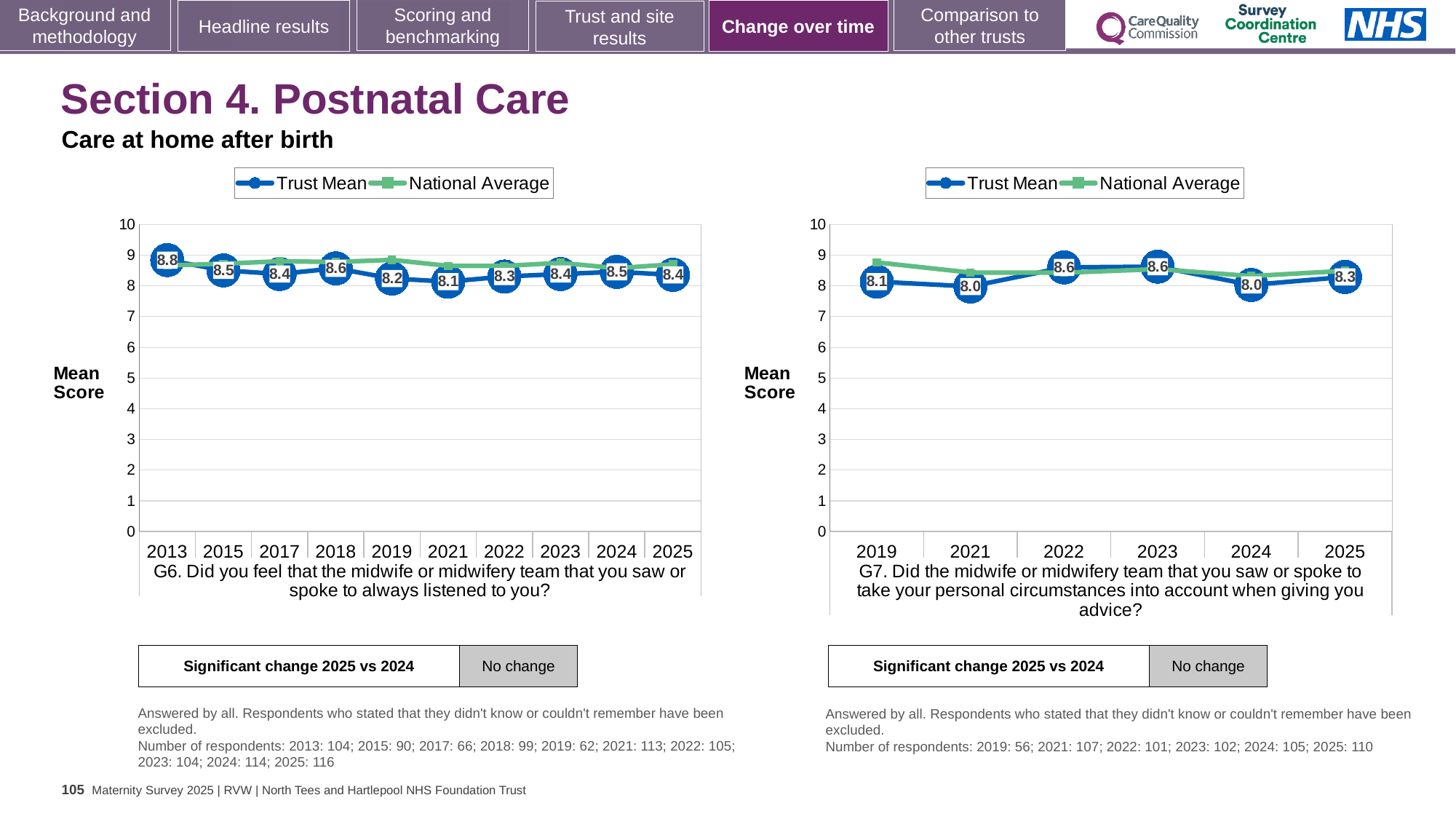
In the G7 chart on the right, what is the Trust Mean score for 2025? 8.3 In the G6 chart on the left, which year has the lowest Trust Mean score? 2021 What kind of chart is the G6 chart on the left? Line chart In the G6 chart on the left, what is the Trust Mean score for 2021? 8.1 In the G7 chart on the right, what is the difference between the Trust Mean scores for 2022 and 2024? 0.6 In the G7 chart on the right, is the Trust Mean score higher in 2023 or in 2024? 2023 In the G6 chart on the left, what is the Trust Mean score for 2013? 8.8 How many series does the legend of the G7 chart on the right list? 2 In the G6 chart on the left, what is the difference between the Trust Mean scores for 2013 and 2021? 0.7 In the G6 chart on the left, which year has the highest Trust Mean score? 2013 How many years are plotted on the x axis of the G6 chart on the left? 10 In the G7 chart on the right, is the National Average value for 2019 greater or less than 8? greater